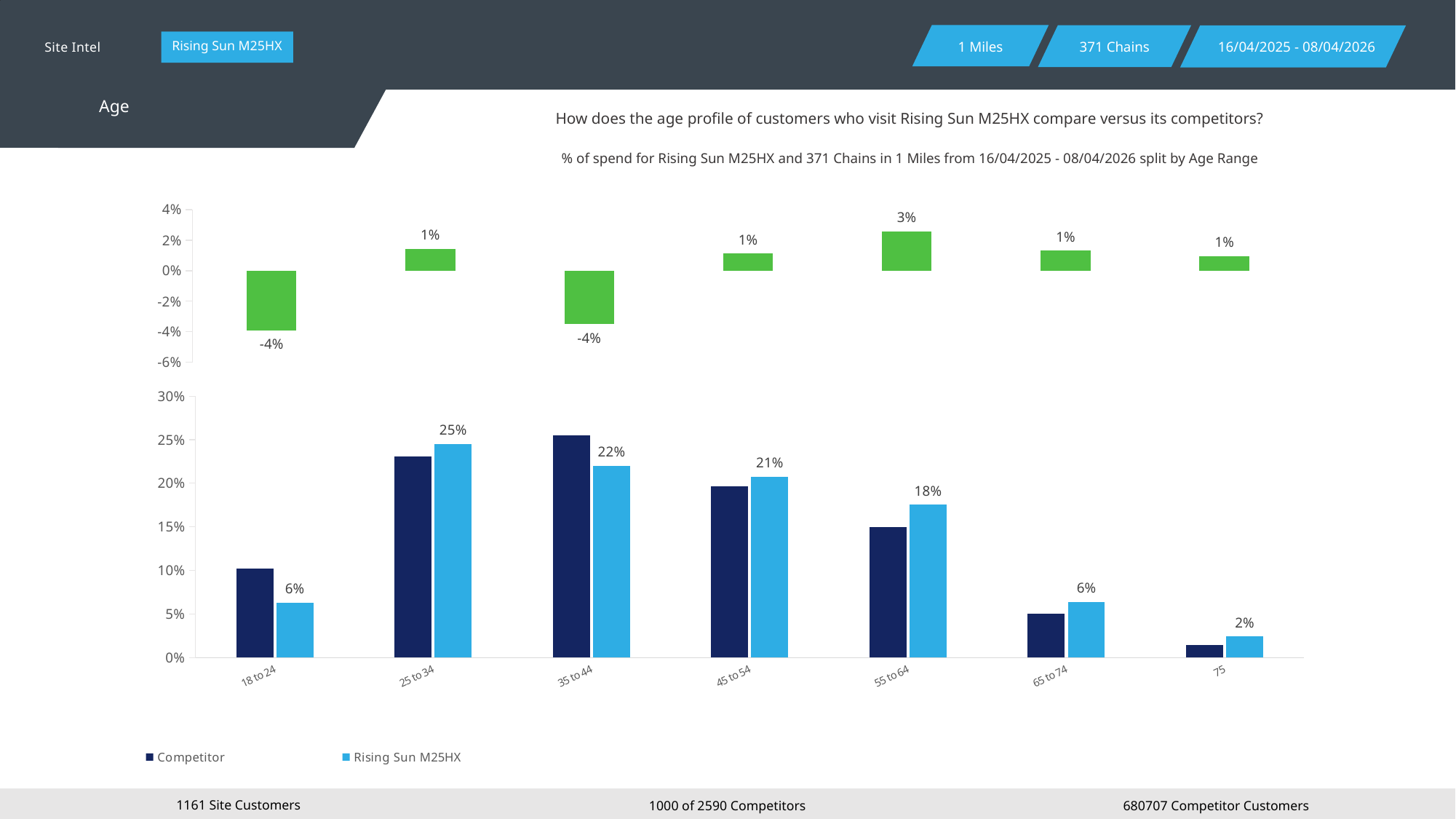
In the top chart, what is the value shown for the 18 to 24 age range? -4% In the top chart, what is the value shown for the 55 to 64 age range? 3% How many series does the legend of the bottom chart list? 2 In the bottom chart, what is the value for Rising Sun M25HX in the 25 to 34 age range? 25% In the bottom chart, which age range has the lowest value for Rising Sun M25HX? 75 In the bottom chart, what is the difference between the Rising Sun M25HX values for 35 to 44 and 45 to 54? 1% In the bottom chart, for the 18 to 24 age range, which is larger: the Competitor bar or the Rising Sun M25HX bar? Competitor What type of chart is the bottom chart? Bar chart How many age range categories are shown on the bottom chart's x axis? 7 In the bottom chart, what is the value for Rising Sun M25HX in the 55 to 64 age range? 18% In the bottom chart, which age range has the highest value for Rising Sun M25HX? 25 to 34